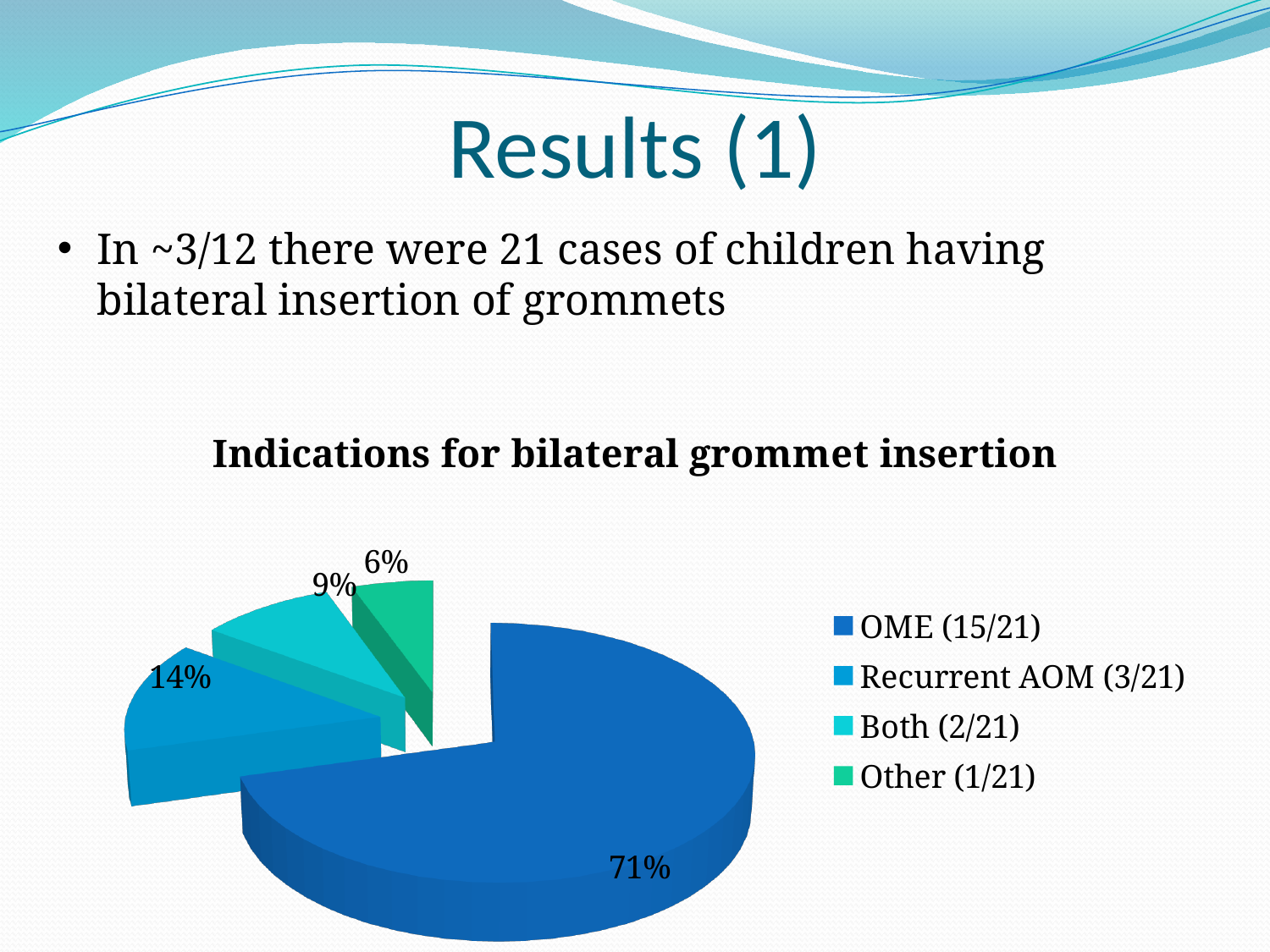
What percentage of the pie does Recurrent AOM (3/21) account for? 14% How many categories does the pie chart show? 4 What kind of chart is shown on the slide? Pie chart What percentage of the pie does Both (2/21) account for? 9% What is the difference in percentage points between the OME (15/21) slice and the Recurrent AOM (3/21) slice? 57 Which category has the largest slice of the pie? OME (15/21) Which slice is larger, Both (2/21) or Other (1/21)? Both (2/21) How many entries does the legend list? 4 What is the title of the chart? Indications for bilateral grommet insertion What percentage of the pie does OME (15/21) account for? 71% Which category has the smallest slice of the pie? Other (1/21)